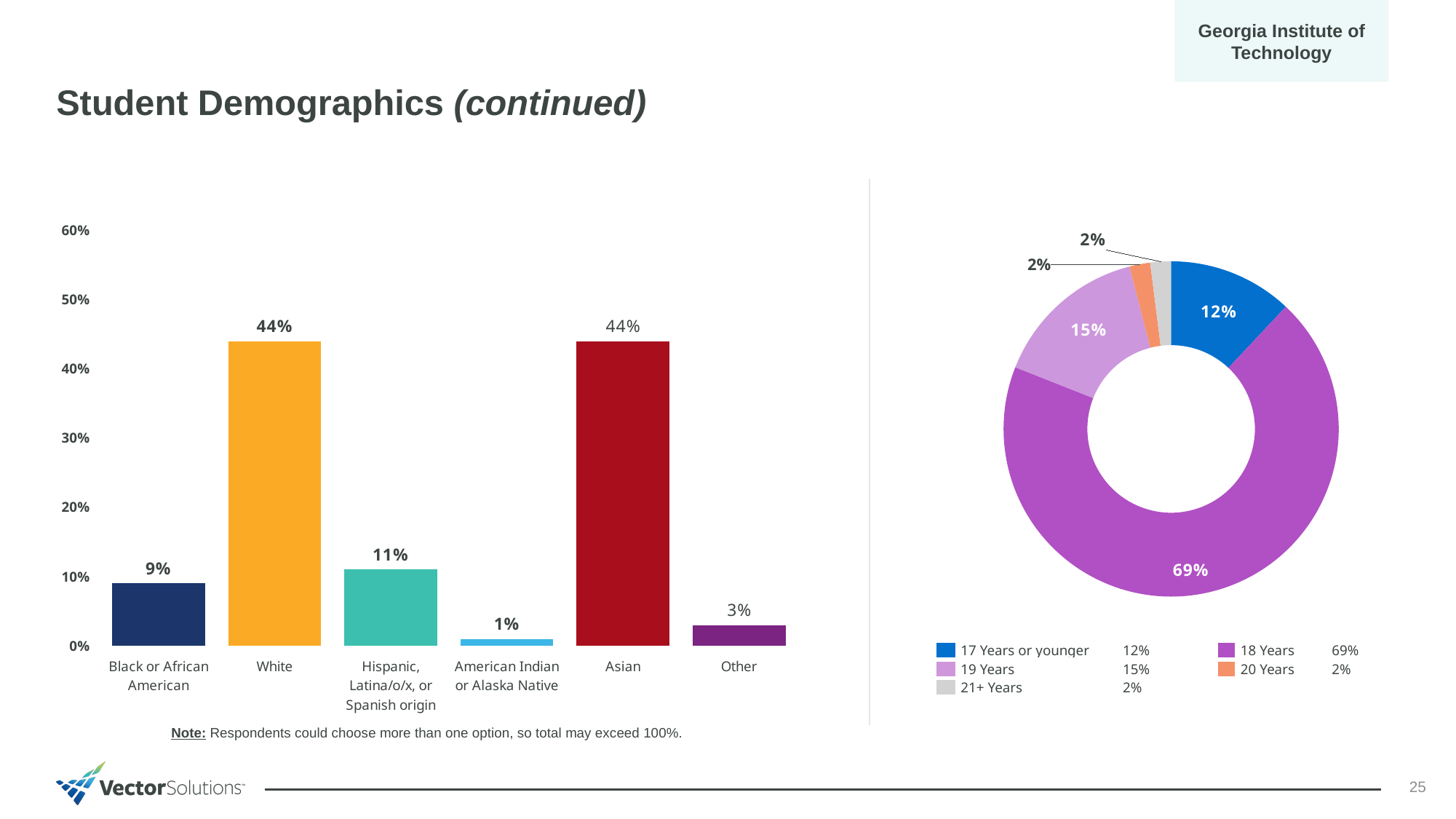
In the donut chart on the right, what share is 19 Years? 15% In the bar chart on the left, what is the value for Black or African American? 9% In the bar chart on the left, how many categories are shown on the x axis? 6 In the donut chart on the right, what share is 18 Years? 69% In the bar chart on the left, which is larger, the value for Hispanic, Latina/o/x, or Spanish origin or the value for Black or African American? Hispanic, Latina/o/x, or Spanish origin How many entries does the legend of the donut chart on the right list? 5 In the donut chart on the right, which category has the largest share? 18 Years In the donut chart on the right, what is the difference between the shares for 17 Years or younger and 20 Years? 10% In the bar chart on the left, what is the value for Hispanic, Latina/o/x, or Spanish origin? 11% In the bar chart on the left, which category has the lowest value? American Indian or Alaska Native What kind of chart is on the left side of the slide? Bar chart In the bar chart on the left, what is the difference between the values for White and Other? 41%